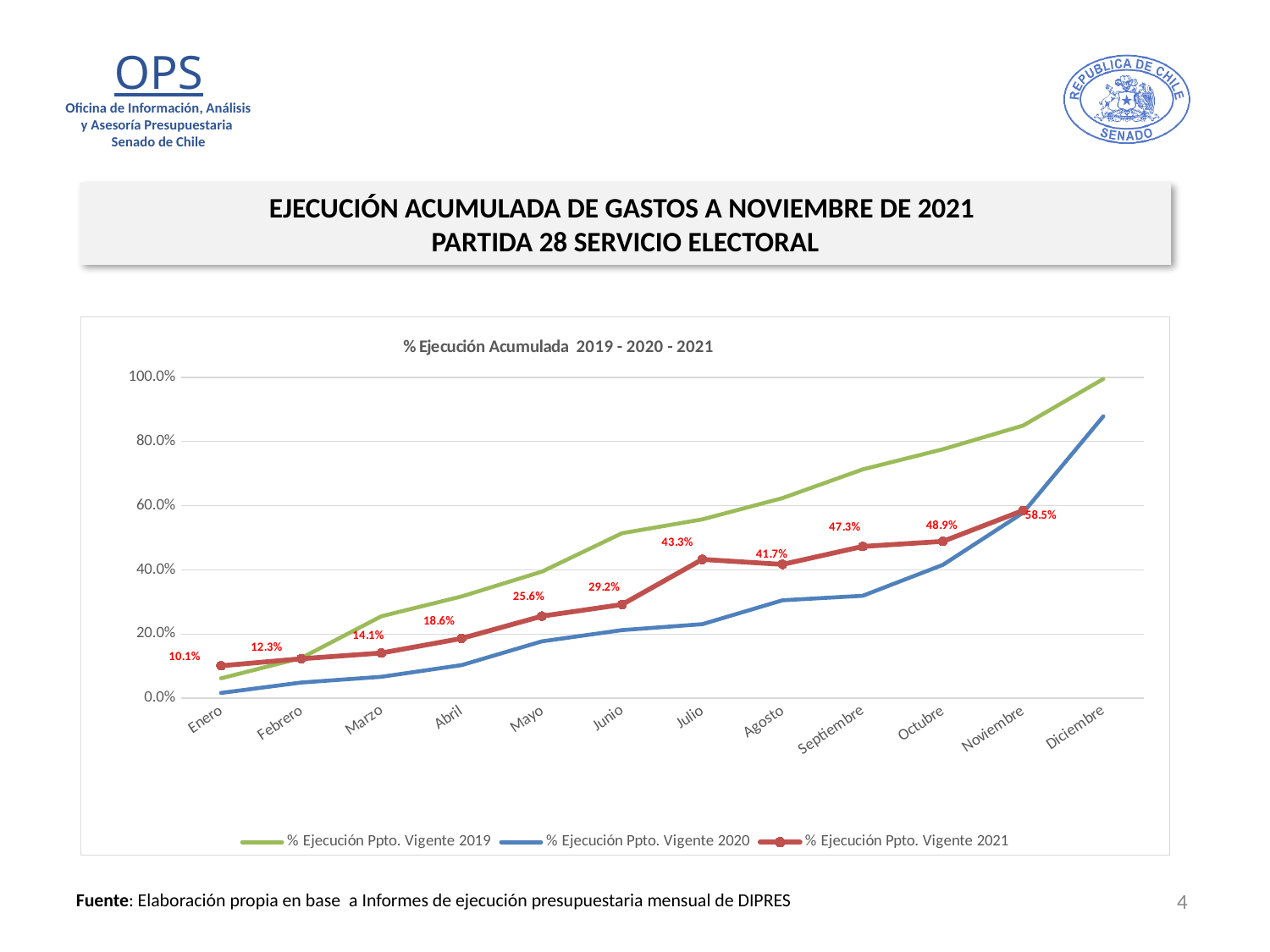
Which month has the highest value in the % Ejecución Ppto. Vigente 2021 series? Noviembre What is the value for Julio in the % Ejecución Ppto. Vigente 2021 series? 43.3% Which month has the lowest value in the % Ejecución Ppto. Vigente 2021 series? Enero In the % Ejecución Ppto. Vigente 2021 series, which is larger, the value for Julio or the value for Agosto? Julio How many months are shown on the x axis of the chart? 12 How many series does the chart legend list? 3 What type of chart is shown on the slide? Line chart Is the value for Marzo in the % Ejecución Ppto. Vigente 2019 series greater or less than 20.0%? greater Is the value for Diciembre in the % Ejecución Ppto. Vigente 2020 series greater or less than 80.0%? greater What is the value for Noviembre in the % Ejecución Ppto. Vigente 2021 series? 58.5% What is the difference between the Noviembre and Octubre values in the % Ejecución Ppto. Vigente 2021 series? 9.6% What is the value for Enero in the % Ejecución Ppto. Vigente 2021 series? 10.1%